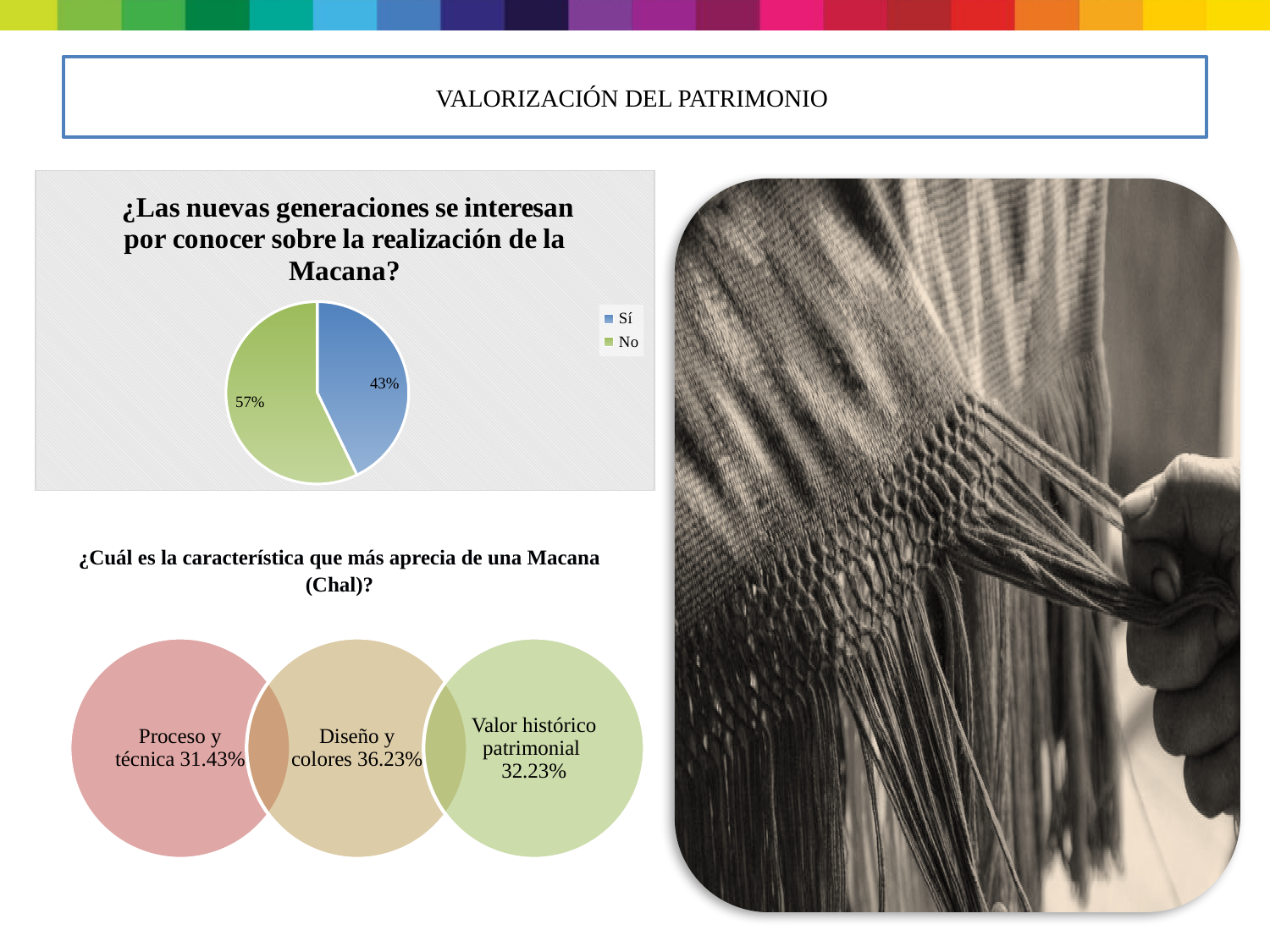
In the pie chart about whether new generations are interested in the Macana, which response has the larger share? No In the pie chart titled '¿Las nuevas generaciones se interesan por conocer sobre la realización de la Macana?', what percentage answered 'No'? 57% In the circle diagram under '¿Cuál es la característica que más aprecia de una Macana (Chal)?', which characteristic has the lowest percentage? Proceso y técnica In the pie chart about whether new generations are interested in the Macana, what is the difference in percentage points between 'No' and 'Sí'? 14 percentage points What type of chart is used for the question '¿Las nuevas generaciones se interesan por conocer sobre la realización de la Macana?' pie chart How many entries does the legend of the pie chart about whether new generations are interested in the Macana list? 2 In the pie chart about whether new generations are interested in the Macana, what colour is the 'No' slice? green In the pie chart about whether new generations are interested in the Macana, which response has the smaller share? Sí In the circle diagram under '¿Cuál es la característica que más aprecia de una Macana (Chal)?', what percentage is shown for 'Diseño y colores'? 36.23% How many slices does the pie chart about whether new generations are interested in the Macana have? 2 In the pie chart about whether new generations are interested in the Macana, is the share for 'Sí' larger or smaller than the share for 'No'? smaller In the pie chart titled '¿Las nuevas generaciones se interesan por conocer sobre la realización de la Macana?', what percentage answered 'Sí'? 43%